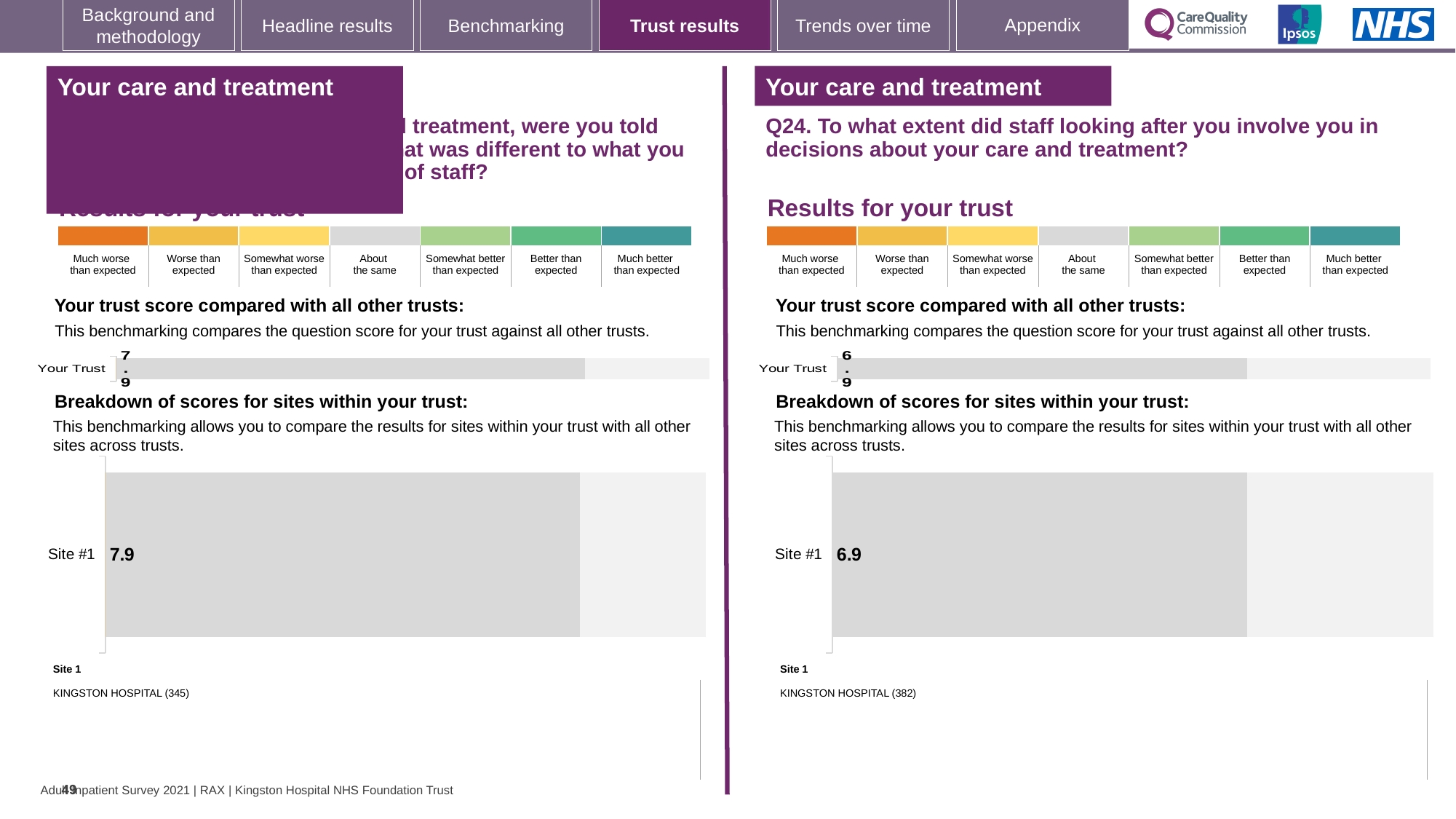
Is the Your Trust score in the right (Q24) chart greater or less than the Your Trust score in the left chart? less Which site name is listed under Site 1 for the left breakdown chart? KINGSTON HOSPITAL (345) Which site name is listed under Site 1 for the right (Q24) breakdown chart? KINGSTON HOSPITAL (382) On the right half of the slide (Q24), what is the score shown for Your Trust in the 'Your trust score compared with all other trusts' chart? 6.9 In the left 'Breakdown of scores for sites within your trust' chart, what is the value for Site #1? 7.9 In the right 'Breakdown of scores for sites within your trust' chart (Q24), what is the value for Site #1? 6.9 Which is larger: the Site #1 score in the left breakdown chart or the Site #1 score in the right breakdown chart? The left chart (7.9) How many sites are plotted in the right 'Breakdown of scores for sites within your trust' chart? 1 What kind of chart is used for the 'Breakdown of scores for sites within your trust' on the left half of the slide? Bar chart On the left half of the slide, what is the score shown for Your Trust in the 'Your trust score compared with all other trusts' chart? 7.9 What is the difference between the Site #1 score in the left breakdown chart and the Site #1 score in the right breakdown chart? 1.0 How many sites are plotted in the left 'Breakdown of scores for sites within your trust' chart? 1